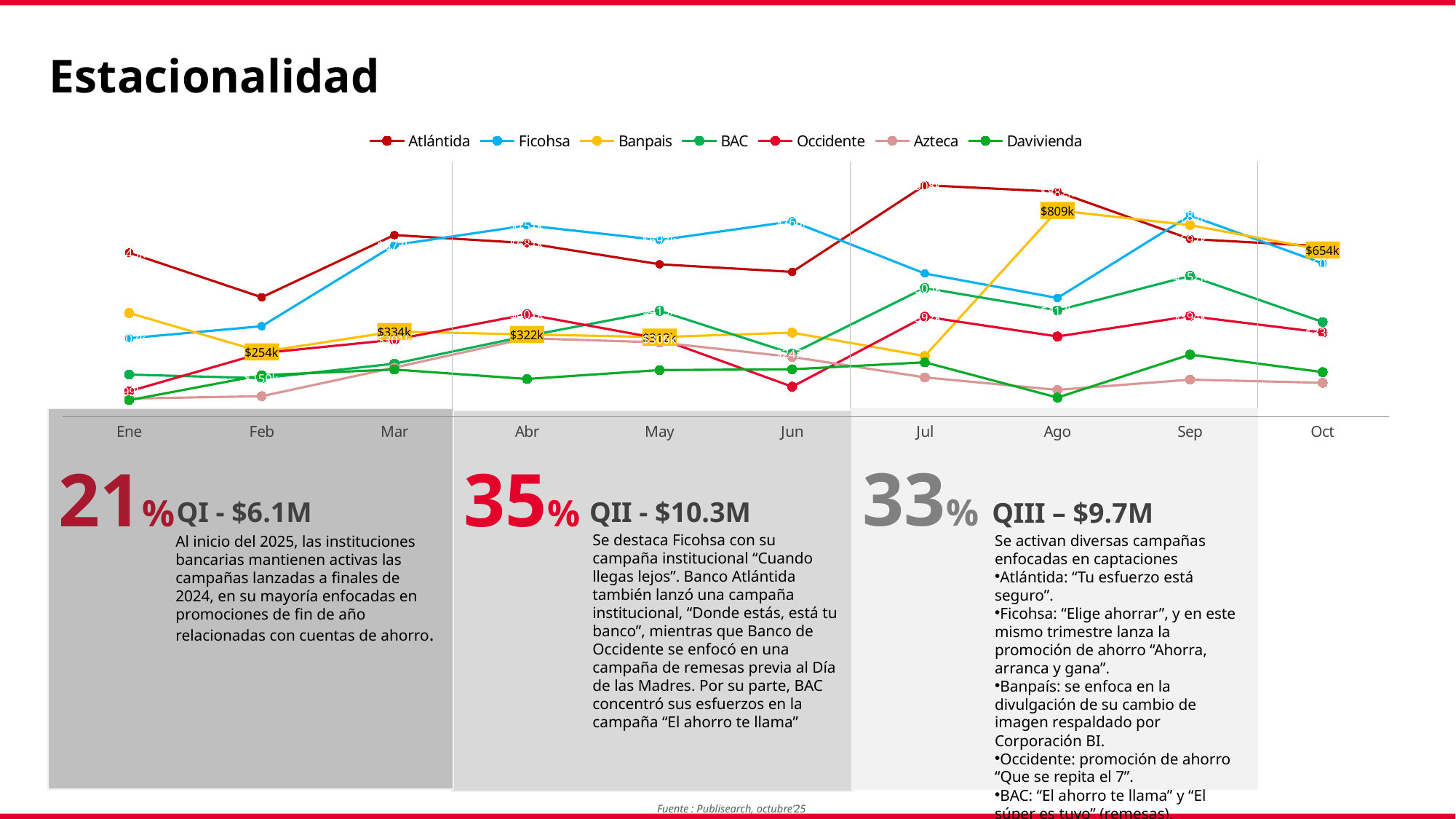
In which month does Banpais reach its highest value? Ago What is the value for Banpais in Mar? $334k Which series has the highest value in Jul? Atlántida How many months are shown along the x axis? 10 What is the difference between the Banpais values in Ago and Oct? $155k What is the value for Banpais in Oct? $654k Does the Banpais line rise or fall from Jul to Ago? rise What kind of chart is shown on the slide? line chart Which is larger for Banpais, the value in Mar or the value in Feb? Mar How many series does the legend list? 7 What is the value for Banpais in Ago? $809k What is the value for Banpais in Feb? $254k